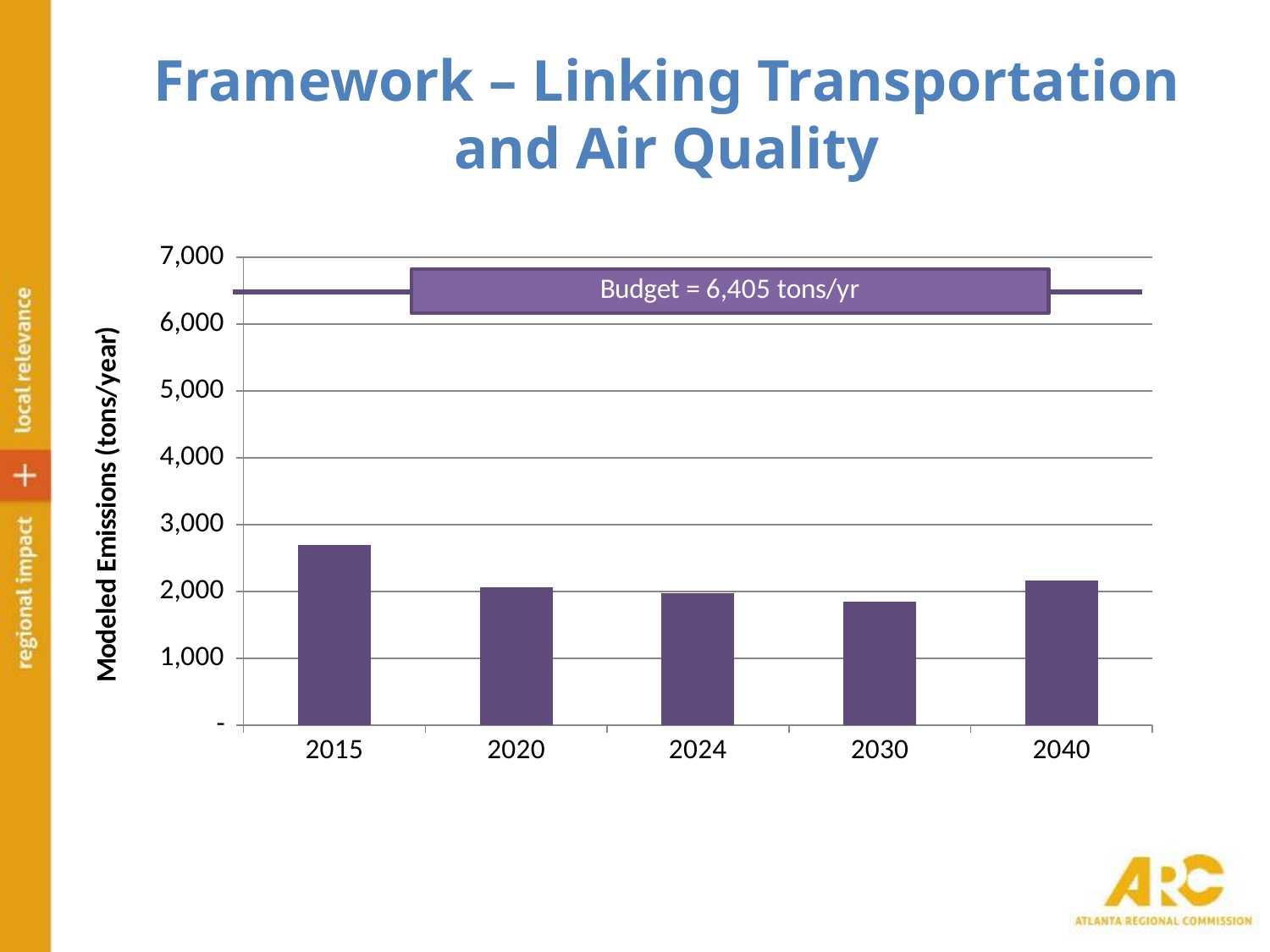
Do modeled emissions rise or fall from 2015 to 2030? fall What is the label on the y axis of the chart? Modeled Emissions (tons/year) Which year has the lowest modeled emissions? 2030 Is the value for 2015 greater or less than 3,000? less What is the emissions budget shown on the chart? 6,405 tons/yr How many years are plotted on the x axis of the chart? 5 Is the value for 2015 greater or less than 2,000? greater Is the value for 2030 greater or less than 2,000? less Which year has higher modeled emissions, 2015 or 2020? 2015 Which year has the highest modeled emissions? 2015 What kind of chart is shown on the slide? bar chart